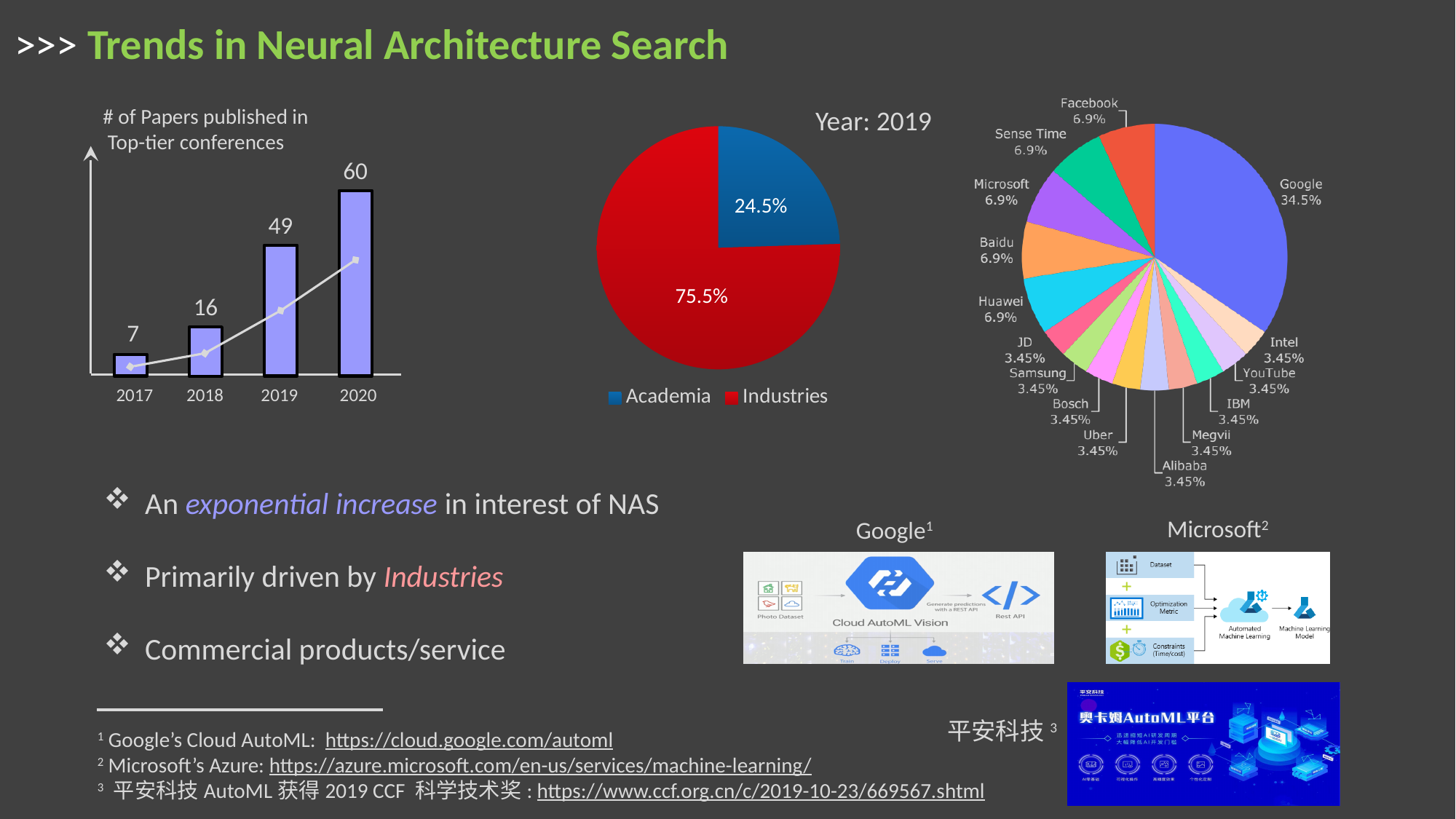
In the '# of Papers published in Top-tier conferences' chart, how many papers were published in 2019? 49 In the 'Year: 2019' pie chart, which is larger, Academia or Industries? Industries What kind of chart is the '# of Papers published in Top-tier conferences' chart? bar chart In the company pie chart on the right, what is the difference between the shares of Google and Microsoft? 27.6% In the '# of Papers published in Top-tier conferences' chart, what is the difference between the 2020 and 2018 values? 44 How many years are shown in the '# of Papers published in Top-tier conferences' chart? 4 In the company pie chart on the right, what share does Google have? 34.5% In the '# of Papers published in Top-tier conferences' chart, do the values rise or fall from 2017 to 2020? rise In the '# of Papers published in Top-tier conferences' chart, which year has the lowest value? 2017 In the 'Year: 2019' pie chart, what share does Academia have? 24.5% In the '# of Papers published in Top-tier conferences' chart, which year has the highest value? 2020 How many series does the legend of the 'Year: 2019' pie chart list? 2